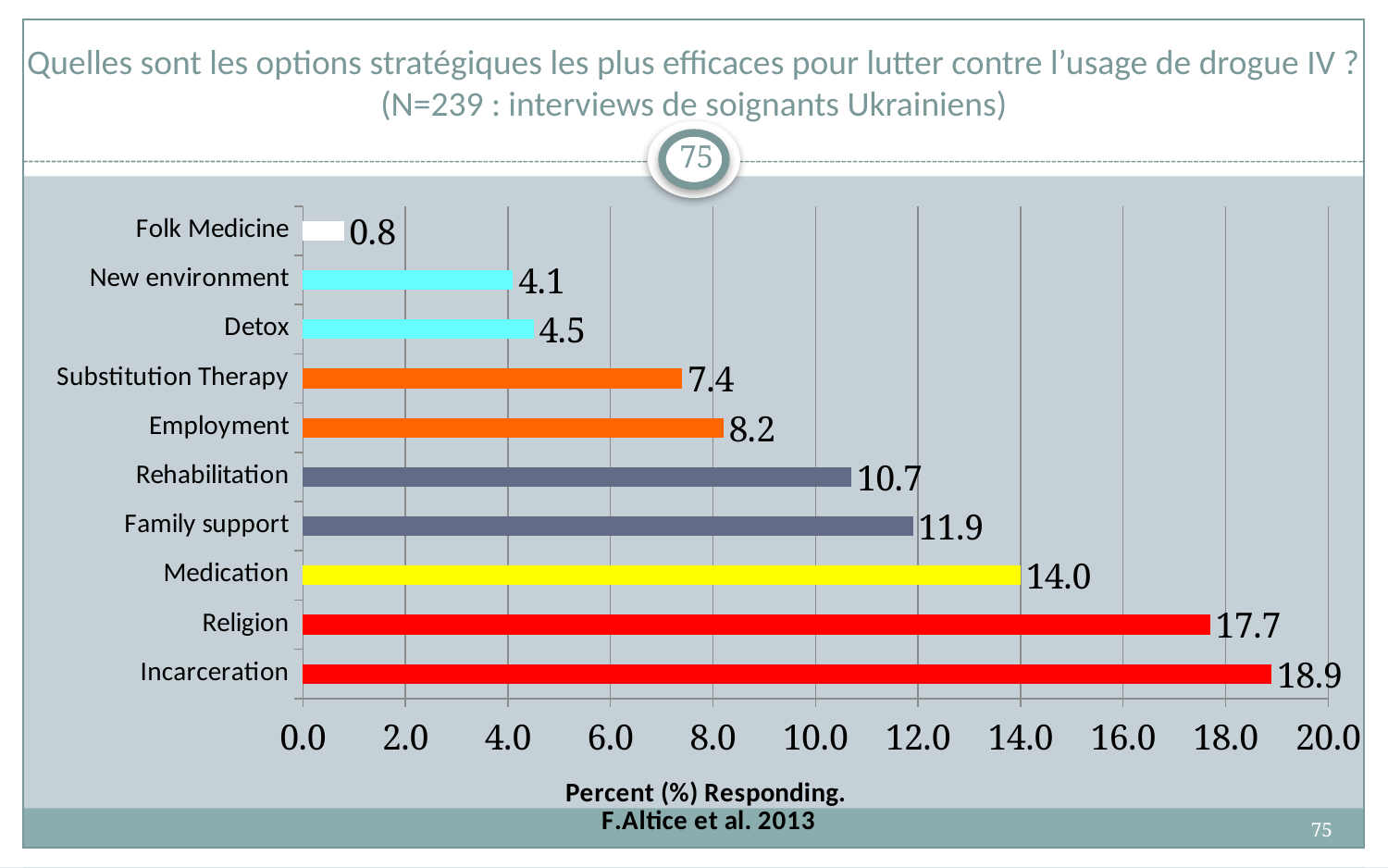
Which category has the highest value? Incarceration What colour is the bar for Medication? yellow What is the value for Substitution Therapy? 7.4 What kind of chart is shown on the slide? bar chart How many categories are shown in the chart? 10 What is the difference between the values for Religion and Medication? 3.7 What is the label of the horizontal axis? Percent (%) Responding. What is the value for Folk Medicine? 0.8 Which category has the lowest value? Folk Medicine Which is larger, the value for Rehabilitation or the value for Employment? Rehabilitation Is the value for Family support greater or less than 10.0? greater What is the value for Incarceration? 18.9